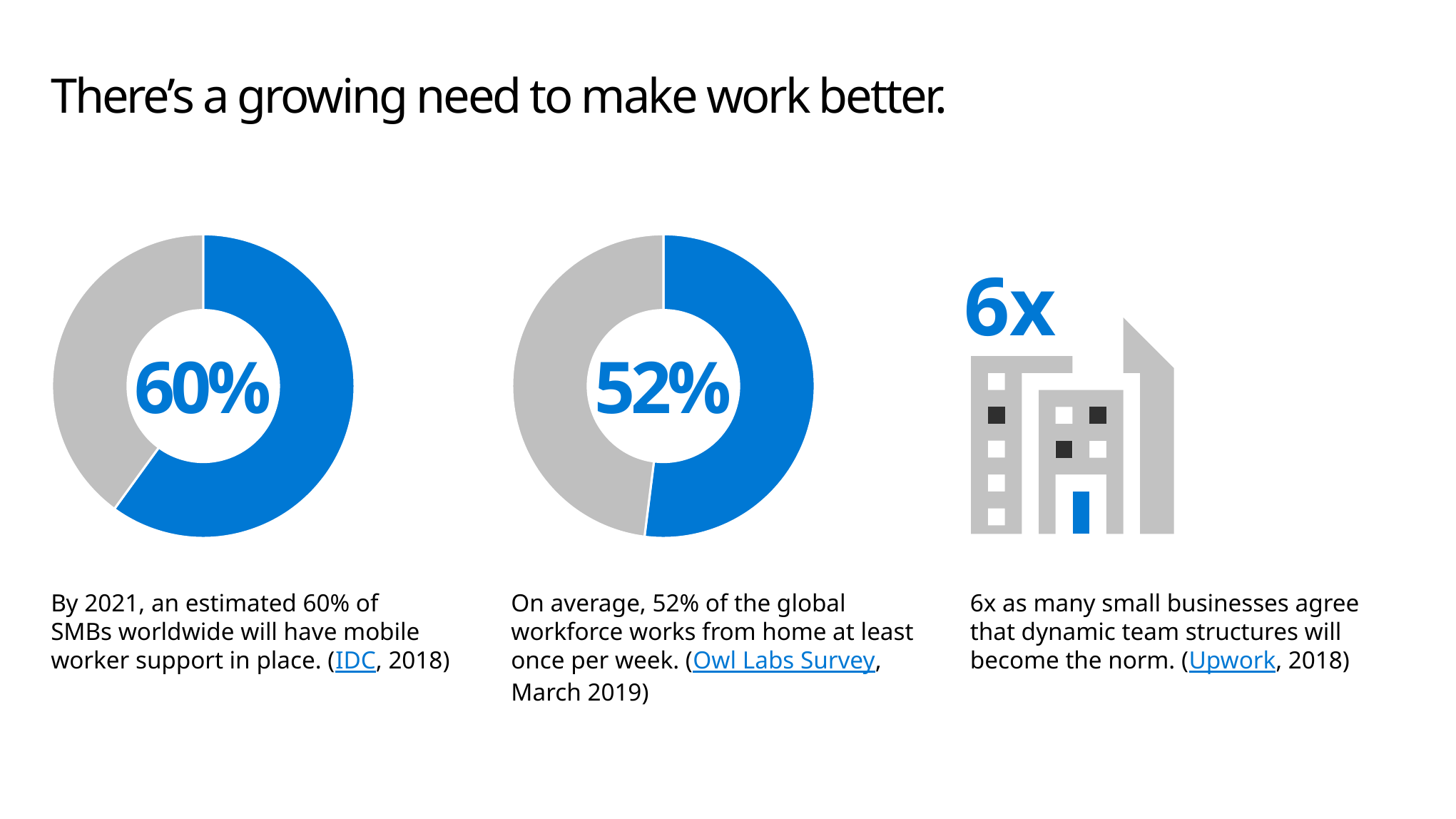
What is the difference between the value in the left donut chart and the value in the middle donut chart? 8 percentage points Is the blue share in the middle donut chart greater or less than 50%? greater What kind of chart is used to show the 60% and 52% figures? Donut (pie) chart What colour is the highlighted segment in the donut charts? Blue How many donut charts are on the slide? 2 In the left donut chart, what share does the grey segment represent? 40% In the middle donut chart, what share does the grey segment represent? 48% Which donut chart shows the larger highlighted share, the left one or the middle one? The left one (60%) What source is cited for the 60% figure in the left donut chart? IDC, 2018 What value is shown in the centre of the left donut chart? 60% What value is shown in the centre of the middle donut chart? 52% How many segments does each donut chart have? 2